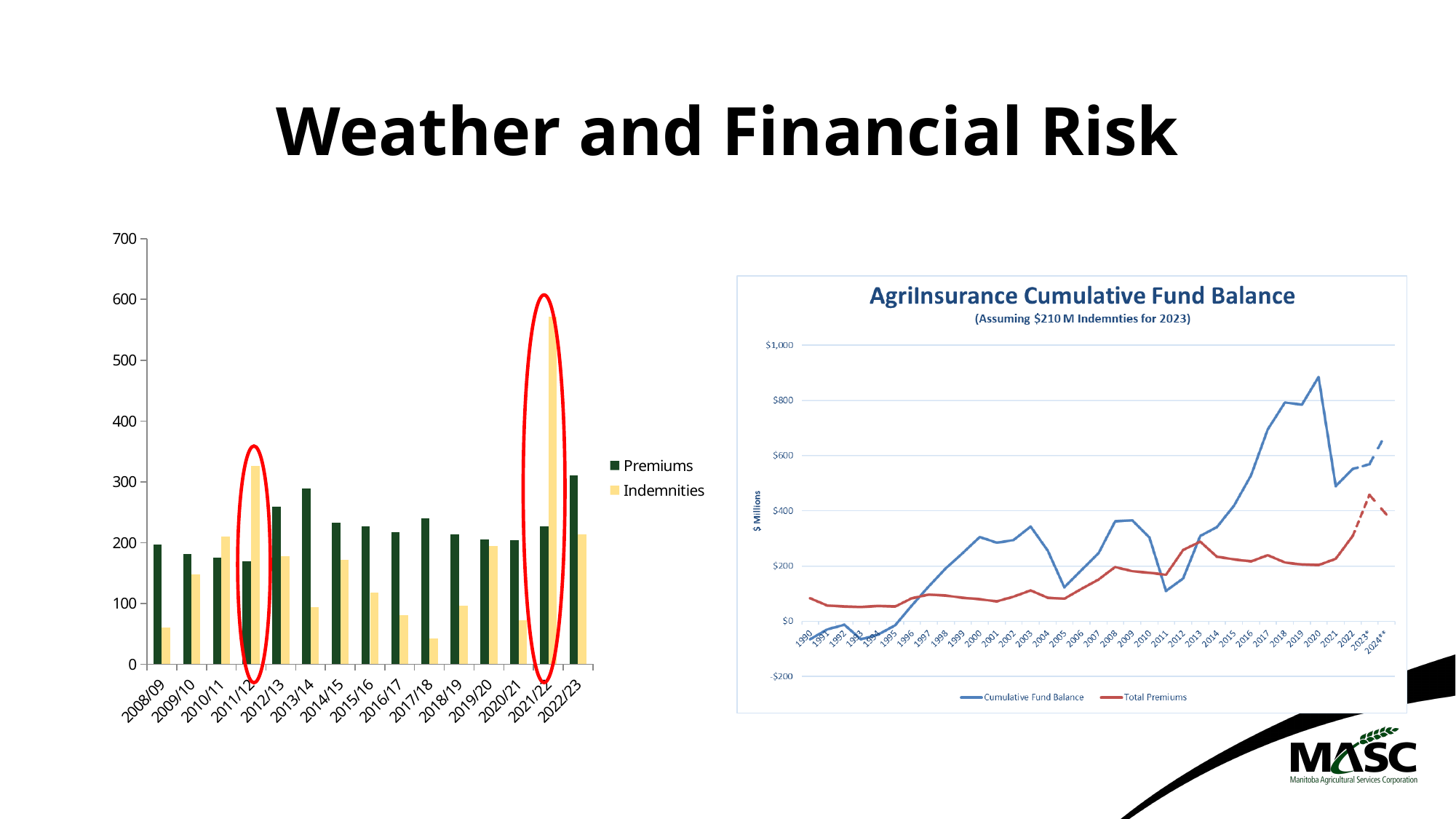
In the bar chart on the left, how many series does the legend list? 2 In the bar chart on the left, is the Indemnities value for 2021/22 greater or less than 500? greater In the bar chart on the left, is the Indemnities value for 2011/12 greater or less than 300? greater In the AgriInsurance Cumulative Fund Balance chart, in which year does the Cumulative Fund Balance reach its highest point? 2020 In the AgriInsurance Cumulative Fund Balance chart, which series does the legend list besides Cumulative Fund Balance? Total Premiums In the bar chart on the left, which year has the lowest Indemnities value? 2017/18 In the bar chart on the left, which year has the highest Indemnities value? 2021/22 What kind of chart is the chart on the left of the slide? bar chart In the bar chart on the left, which is larger for 2012/13, Premiums or Indemnities? Premiums What kind of chart is the AgriInsurance Cumulative Fund Balance chart? line chart In the bar chart on the left, how many crop years are shown on the x axis? 15 In the AgriInsurance Cumulative Fund Balance chart, is the Cumulative Fund Balance for 2020 greater or less than $800? greater